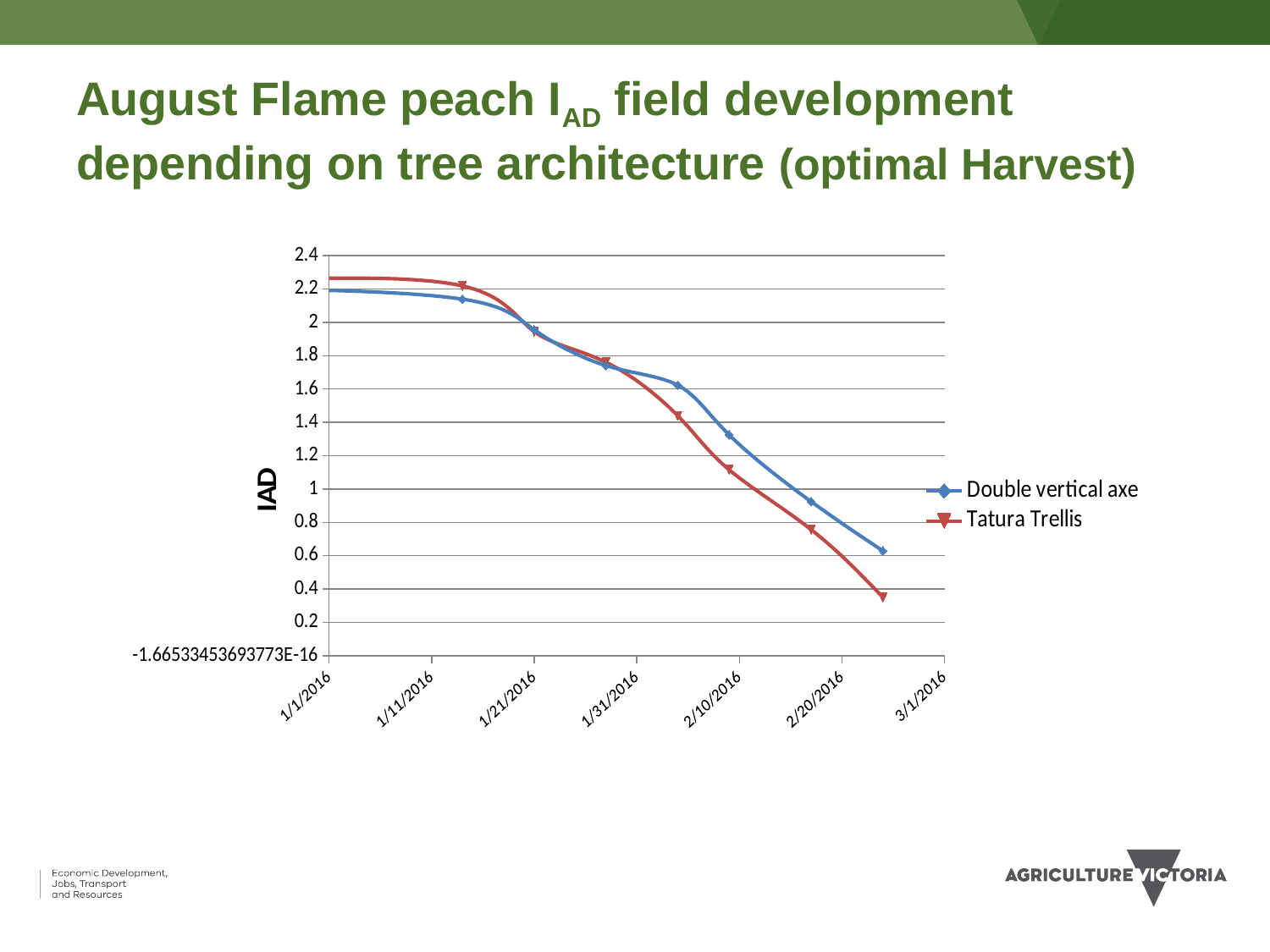
Is the final plotted value for Double vertical axe greater or less than 0.4? greater Is the value for Double vertical axe at 1/1/2016 greater or less than 2? greater Do the values for Tatura Trellis rise or fall over time along the x axis? fall At the last plotted date, which series has the higher IAD value, Double vertical axe or Tatura Trellis? Double vertical axe Is the final plotted value for Tatura Trellis greater or less than 0.6? less How many series does the legend list? 2 What is the label on the vertical axis of the chart? IAD What kind of chart is shown on the slide? line chart Do the values for Double vertical axe rise or fall from 1/1/2016 to the end of the series? fall At 1/1/2016, which series has the higher IAD value, Double vertical axe or Tatura Trellis? Tatura Trellis Which two series are listed in the chart legend? Double vertical axe and Tatura Trellis